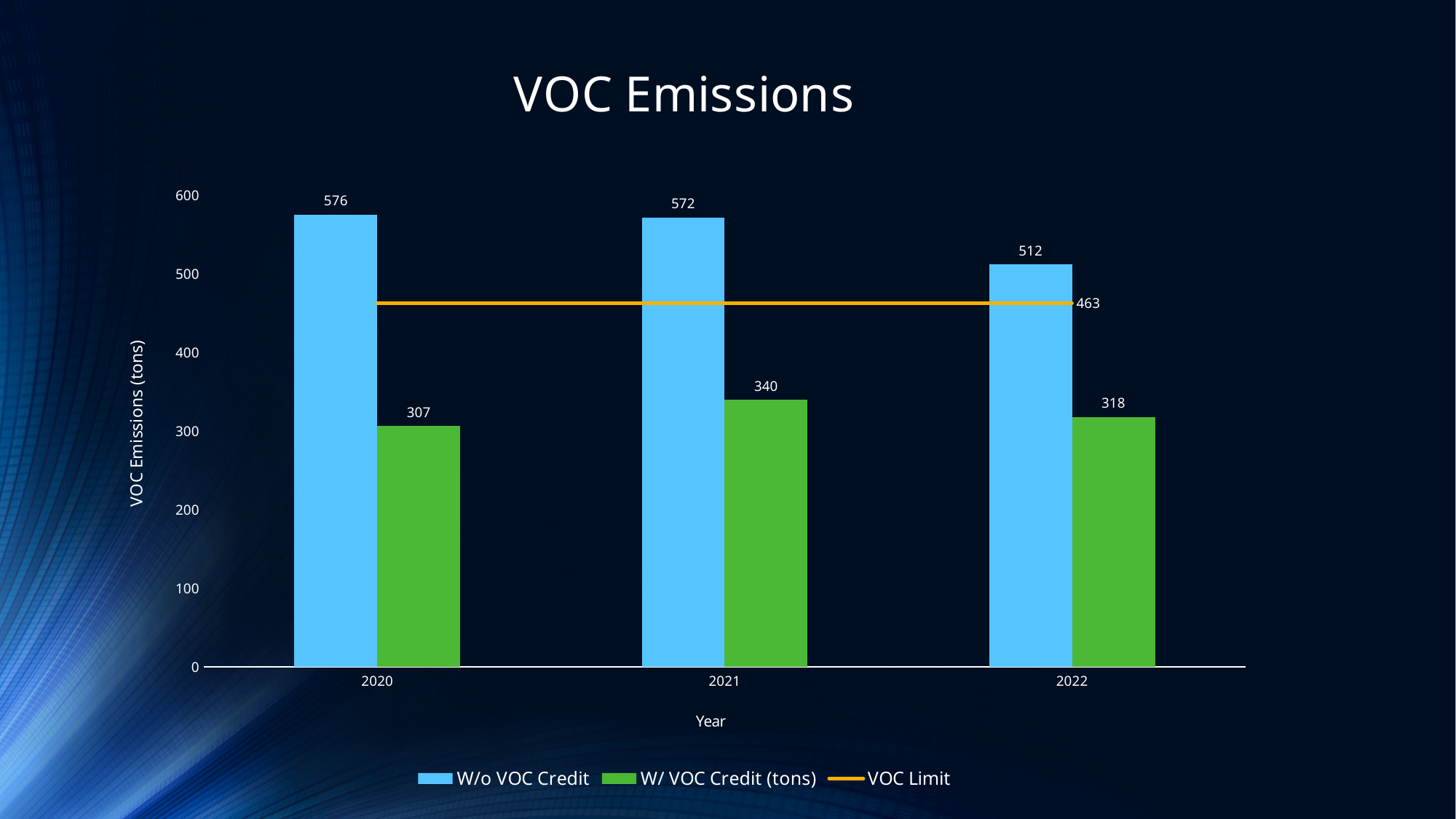
What kind of chart is used for the VOC Credit series? Bar chart What is the value for W/o VOC Credit in 2020? 576 Which year has the lowest W/ VOC Credit (tons) value? 2020 Do the W/o VOC Credit values rise or fall from 2020 to 2022? Fall How many series does the legend list? 3 What is the value for W/ VOC Credit (tons) in 2021? 340 What is the title of the chart? VOC Emissions What is the VOC Limit value shown on the chart? 463 How many years are shown on the x axis? 3 Which is larger: the W/ VOC Credit (tons) value in 2021 or in 2022? 2021 What is the difference between the W/o VOC Credit and W/ VOC Credit (tons) values in 2022? 194 Which year has the highest W/o VOC Credit value? 2020